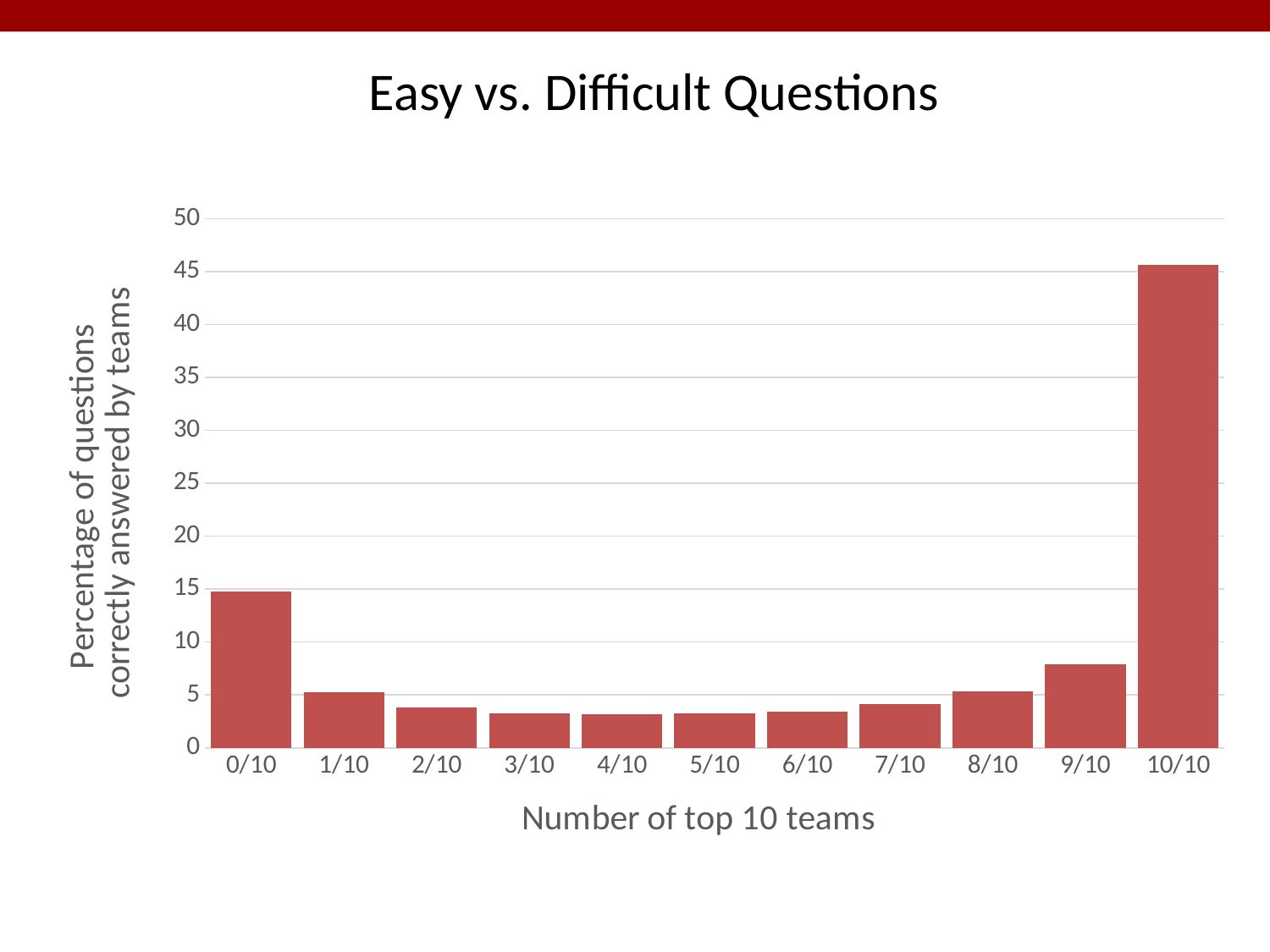
Which is larger, the value for 9/10 or the value for 1/10? 9/10 Is the value for 0/10 greater or less than 10? greater Is the value for 4/10 greater or less than 5? less Is the value for 9/10 greater or less than 10? less Which category has the highest percentage of questions correctly answered? 10/10 What kind of chart is shown on the slide? bar chart What is the label of the x axis? Number of top 10 teams How many categories are shown on the x axis of the chart? 11 Which is larger, the value for 0/10 or the value for 9/10? 0/10 What is the title of the chart? Easy vs. Difficult Questions